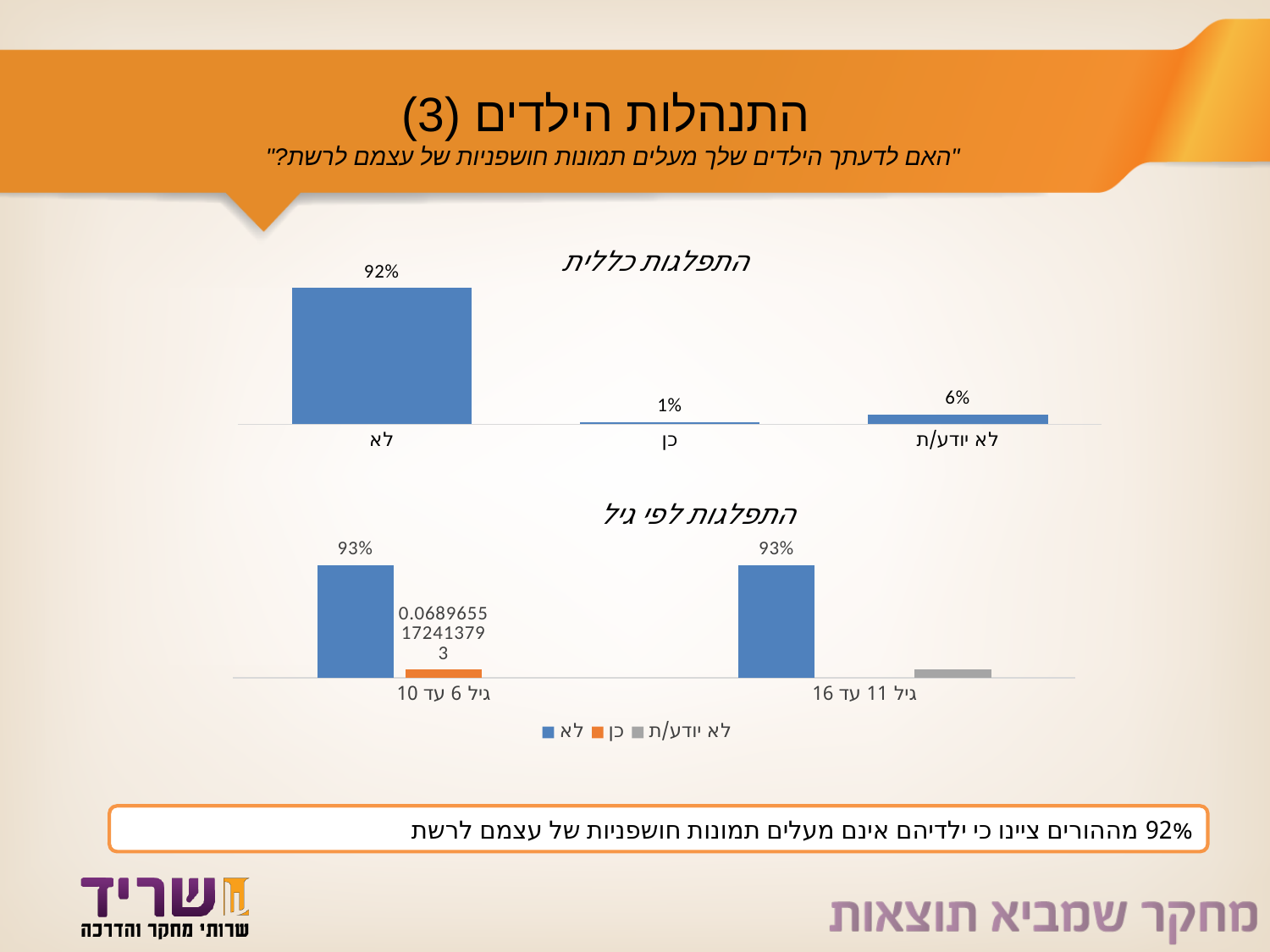
What kind of chart is the top chart titled "התפלגות כללית"? Bar chart In the bottom chart titled "התפלגות לפי גיל", which is larger in the "גיל 6 עד 10" group: "לא" or "כן"? לא In the top chart titled "התפלגות כללית", how many categories are shown? 3 In the bottom chart titled "התפלגות לפי גיל", what is the value for "לא" in the "גיל 6 עד 10" group? 93% In the top chart titled "התפלגות כללית", what is the value for "לא יודע/ת"? 6% In the top chart titled "התפלגות כללית", what is the value for "כן"? 1% In the top chart titled "התפלגות כללית", which category has the highest value? לא In the bottom chart titled "התפלגות לפי גיל", what is the value for "לא" in the "גיל 11 עד 16" group? 93% In the bottom chart titled "התפלגות לפי גיל", how many series does the legend list? 3 In the top chart titled "התפלגות כללית", what is the value for "לא"? 92% In the top chart titled "התפלגות כללית", which category has the lowest value? כן In the top chart titled "התפלגות כללית", what is the difference between the values for "לא" and "לא יודע/ת"? 86%